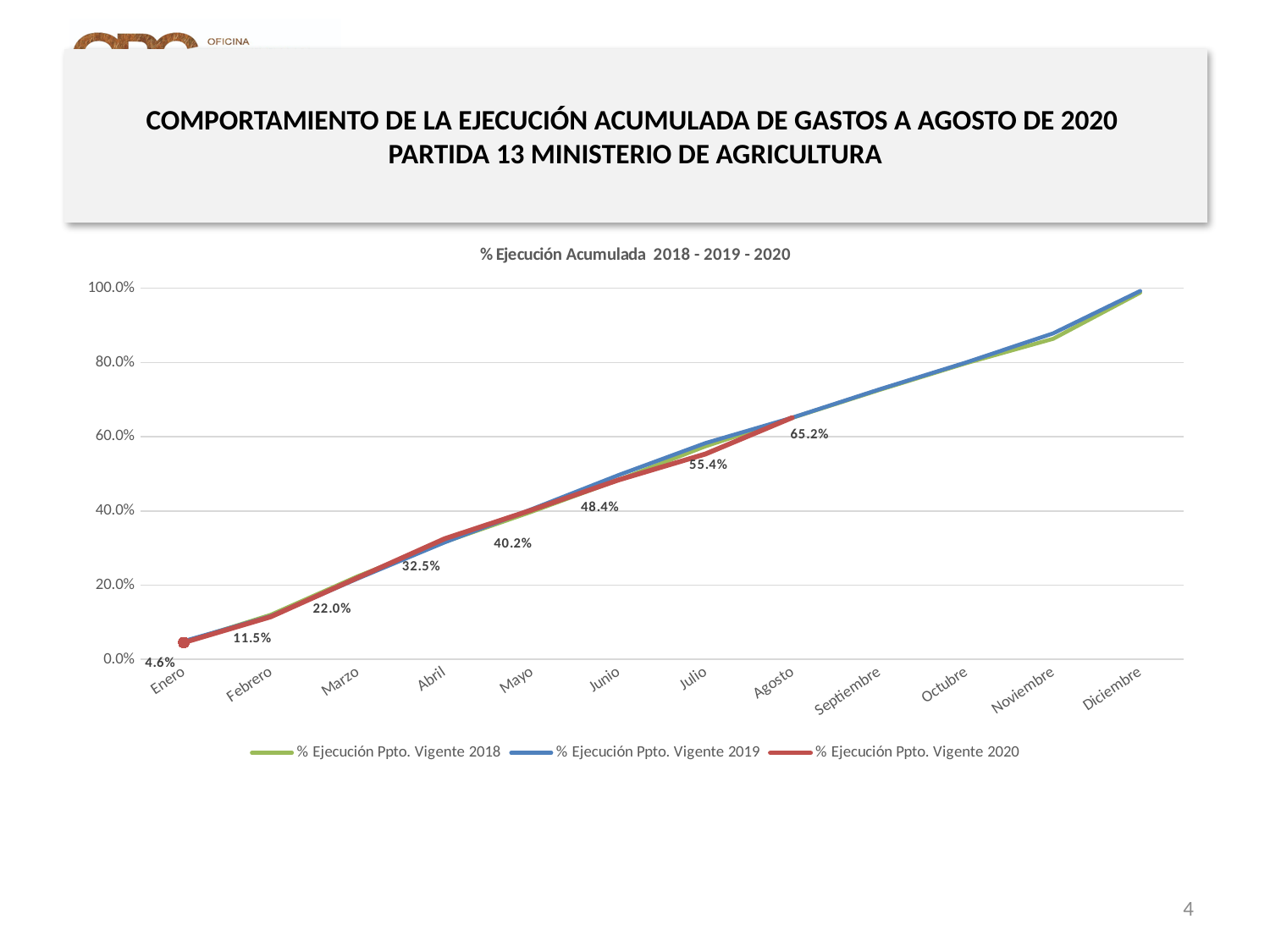
Which is larger for the 2020 series: the value for Abril or the value for Junio? Junio What is the value of % Ejecución Ppto. Vigente 2020 for Marzo? 22.0% Is the value for % Ejecución Ppto. Vigente 2019 in Diciembre greater or less than 80.0%? greater How many series does the legend list? 3 How many months are shown on the x axis? 12 In which month does the % Ejecución Ppto. Vigente 2020 series reach its highest value? Agosto In which month does the % Ejecución Ppto. Vigente 2020 series have its lowest value? Enero What is the difference between the 2020 values for Agosto and Julio? 9.8 percentage points What is the value of % Ejecución Ppto. Vigente 2020 for Mayo? 40.2% What kind of chart is shown on the slide? Line chart What is the value of % Ejecución Ppto. Vigente 2020 for Enero? 4.6% What is the value of % Ejecución Ppto. Vigente 2020 for Agosto? 65.2%